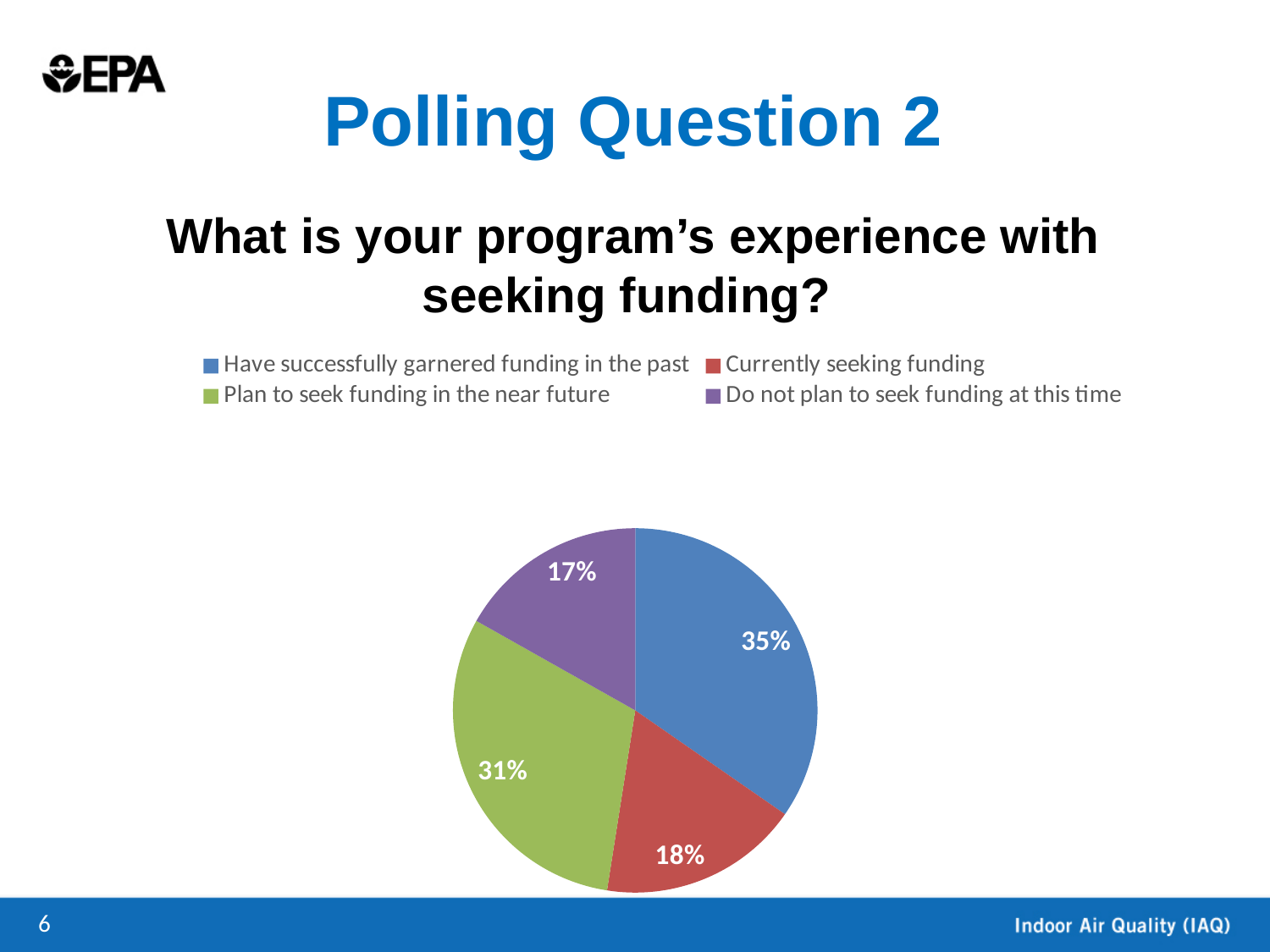
What is the combined share of 'Currently seeking funding' and 'Do not plan to seek funding at this time'? 35% What kind of chart is shown on the slide? Pie chart Which category has the largest slice of the pie? Have successfully garnered funding in the past Which is larger: the slice for 'Currently seeking funding' or the slice for 'Plan to seek funding in the near future'? Plan to seek funding in the near future How many categories does the pie chart show? 4 What share of the pie is labelled for 'Have successfully garnered funding in the past'? 35% What share of the pie is labelled for 'Plan to seek funding in the near future'? 31% Which category has the smallest slice of the pie? Do not plan to seek funding at this time What colour is the slice for 'Plan to seek funding in the near future'? Green What is the difference in percentage points between 'Have successfully garnered funding in the past' and 'Plan to seek funding in the near future'? 4 percentage points What share of the pie is labelled for 'Do not plan to seek funding at this time'? 17%